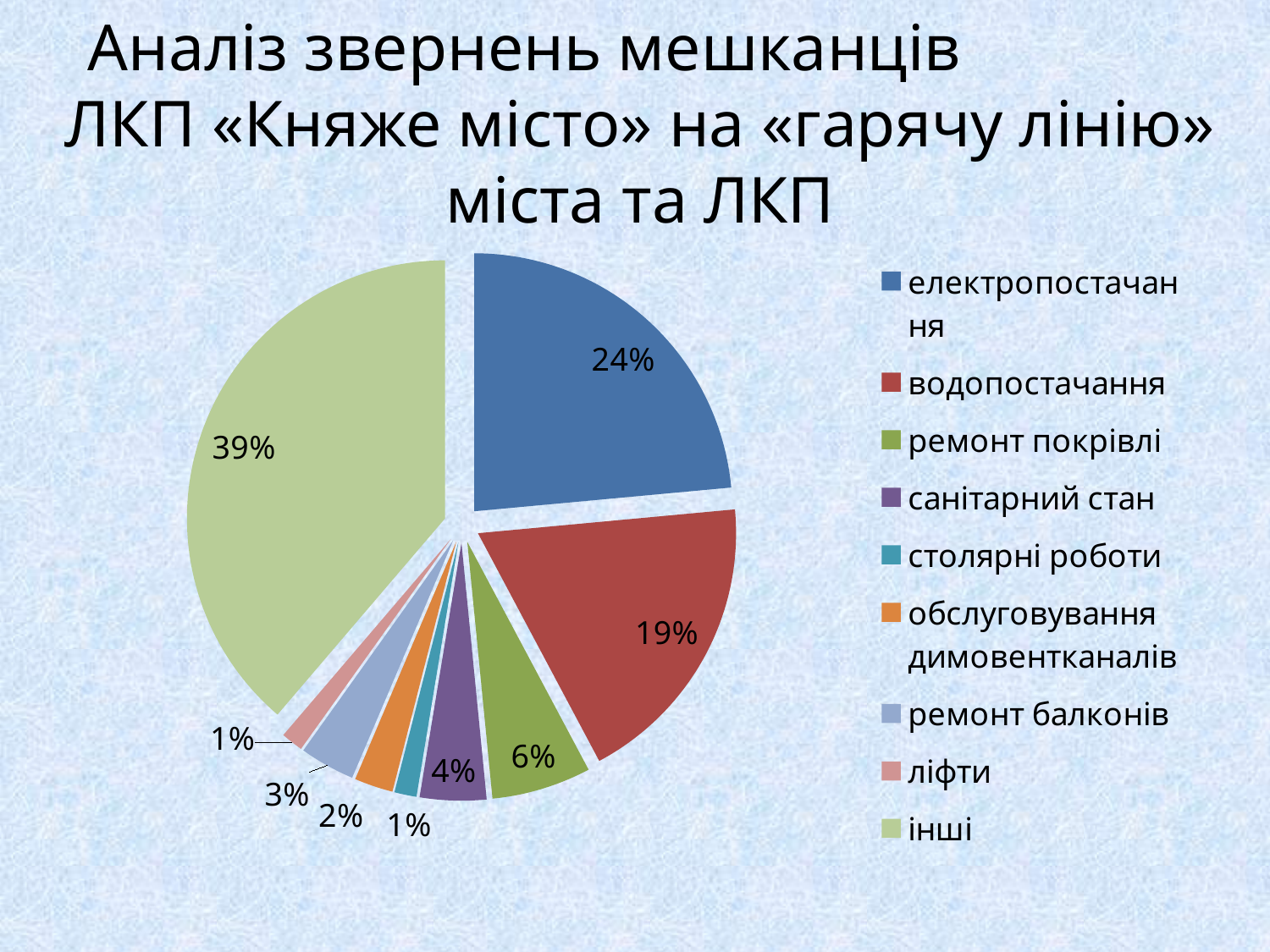
What percentage is shown for водопостачання? 19% Which colour is used for the інші slice? light green Which is larger: the slice for ремонт покрівлі or the slice for санітарний стан? ремонт покрівлі What percentage is shown for ремонт балконів? 3% What share of the pie does the slice for електропостачання represent? 24% What percentage is shown for ремонт покрівлі? 6% What type of chart is shown on the slide? pie chart What is the combined share of електропостачання and водопостачання? 43% What is the difference in percentage points between електропостачання and водопостачання? 5 What percentage is shown for санітарний стан? 4% Which category has the largest slice of the pie? інші How many categories does the legend list? 9